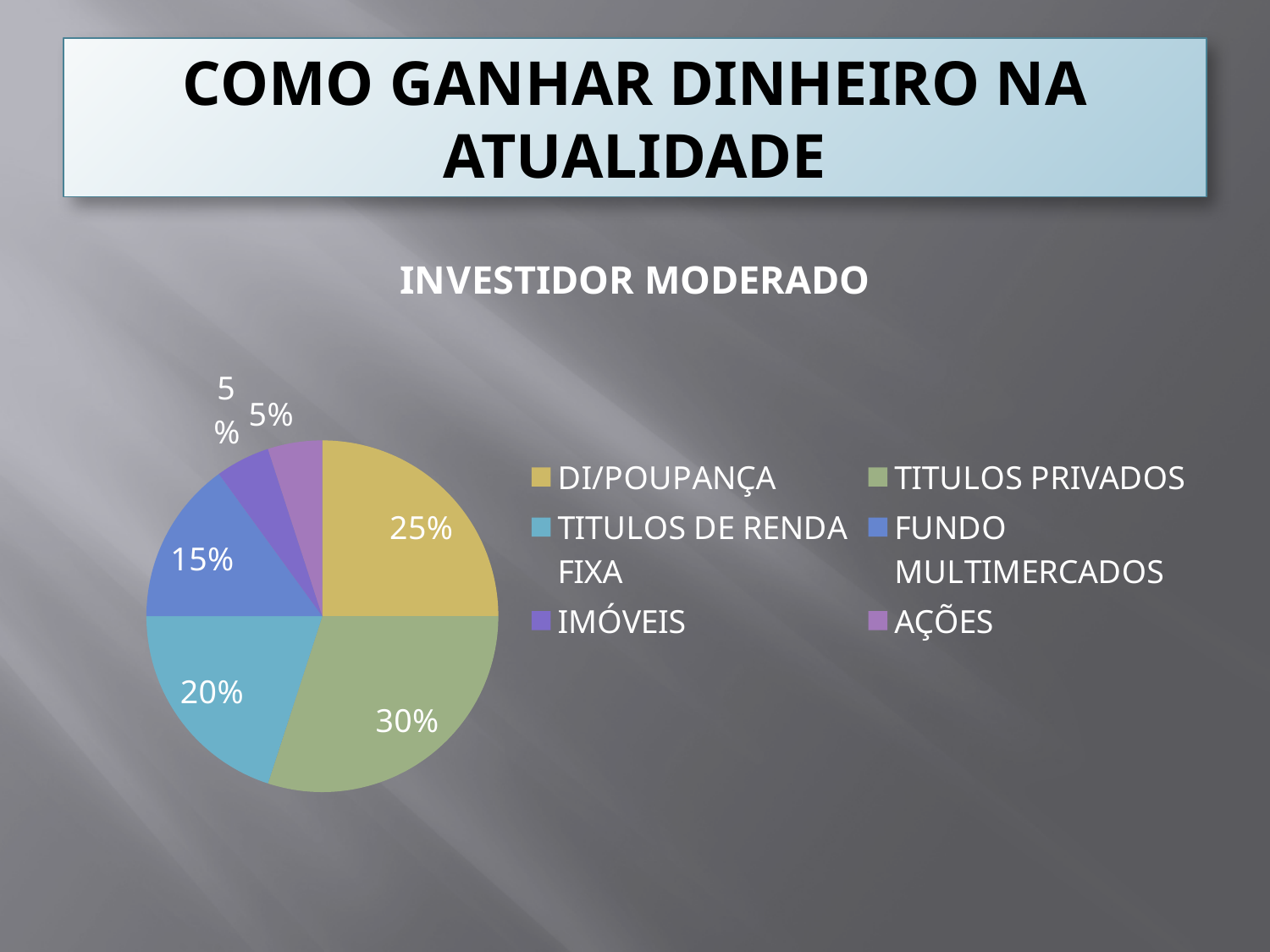
What share of the pie does AÇÕES represent? 5% What colour is the slice for DI/POUPANÇA? Yellow Which category has the largest slice of the pie? TITULOS PRIVADOS What share of the pie does DI/POUPANÇA represent? 25% What is the difference between the shares of TITULOS PRIVADOS and FUNDO MULTIMERCADOS? 15% What share of the pie does TITULOS PRIVADOS represent? 30% What share of the pie does FUNDO MULTIMERCADOS represent? 15% How many categories does the legend list? 6 What share of the pie does TITULOS DE RENDA FIXA represent? 20% What kind of chart is shown on the slide? Pie chart What is the title of the chart? INVESTIDOR MODERADO Which is larger, the share for DI/POUPANÇA or the share for TITULOS DE RENDA FIXA? DI/POUPANÇA